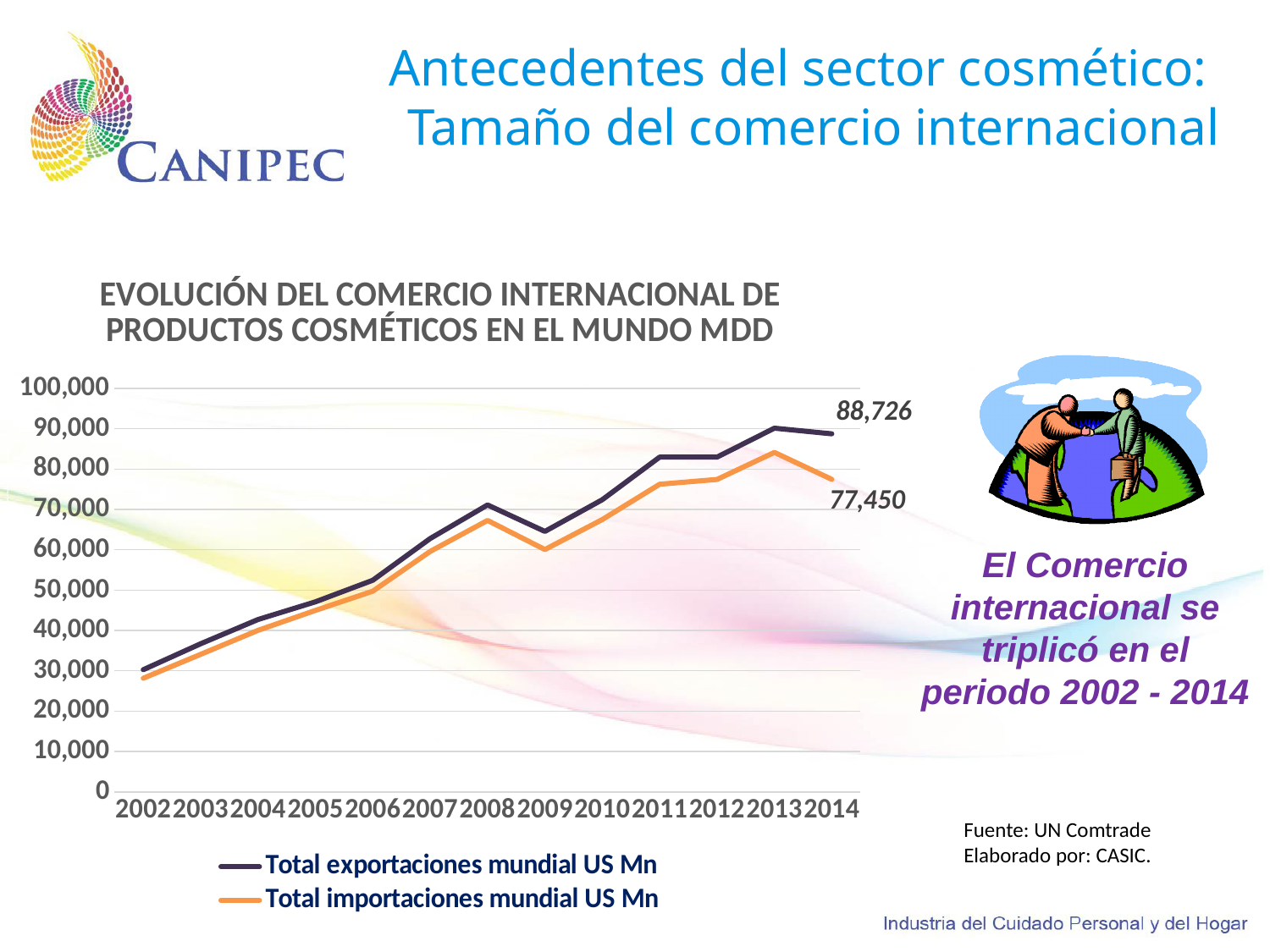
What is the value of Total exportaciones mundial US Mn in 2014? 88,726 What colour is the line for Total importaciones mundial US Mn? orange What is the difference between Total exportaciones mundial and Total importaciones mundial in 2014? 11,276 How many years are plotted along the x axis of the chart? 13 How many series does the chart legend list? 2 Is the value for Total exportaciones mundial in 2002 greater or less than 40,000? less Which year has the lowest value for Total importaciones mundial US Mn? 2002 In 2014, which is larger: Total exportaciones mundial or Total importaciones mundial? Total exportaciones mundial US Mn What kind of chart is shown on the slide? line chart What is the value of Total importaciones mundial US Mn in 2014? 77,450 Is the value for Total importaciones mundial in 2009 greater or less than 70,000? less Do the values of Total exportaciones mundial generally rise or fall from 2002 to 2014? rise